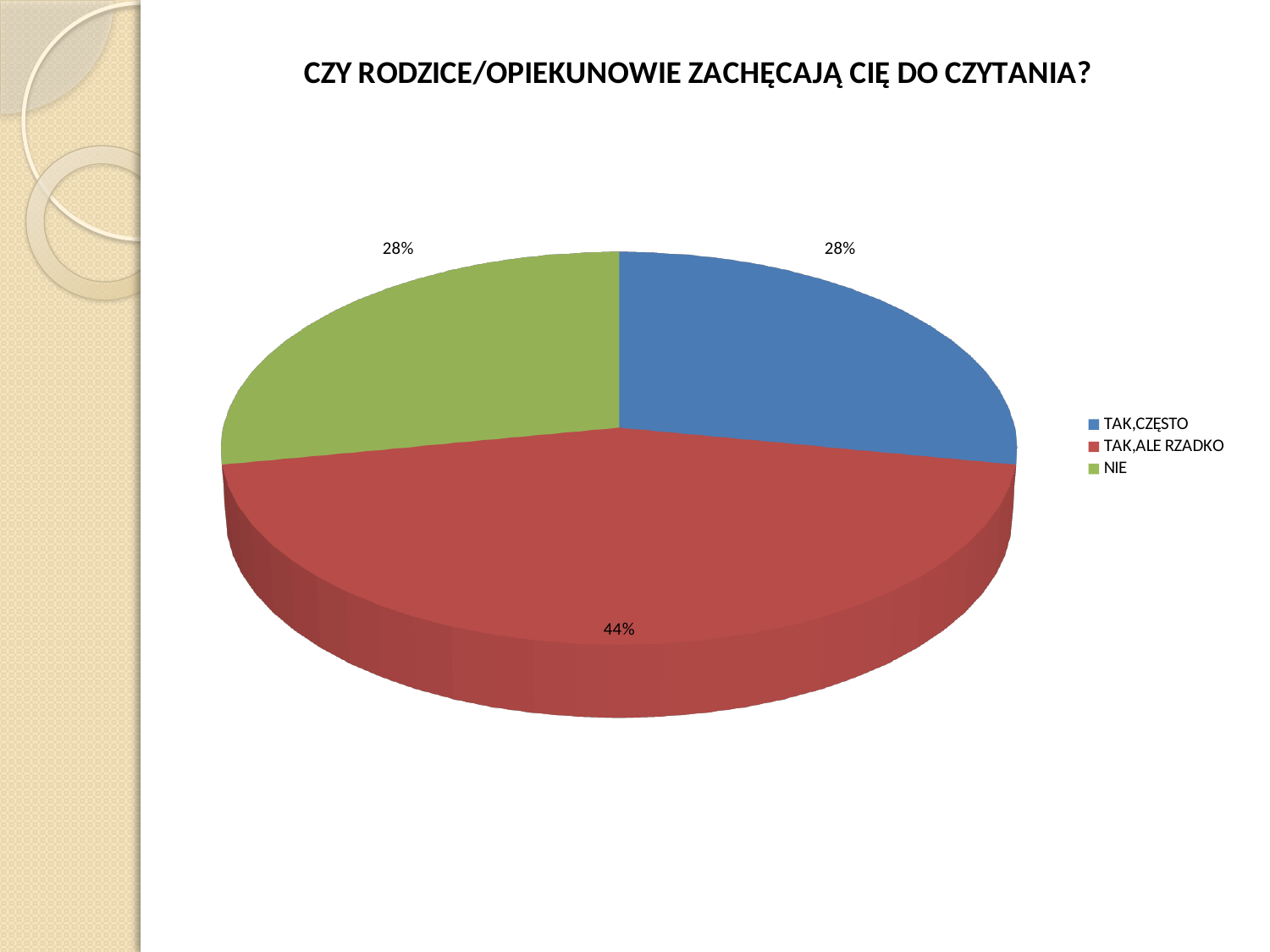
What share of the pie is labelled for TAK,CZĘSTO? 28% What is the combined share of TAK,CZĘSTO and NIE? 56% Which is larger, the slice for TAK,ALE RZADKO or the slice for TAK,CZĘSTO? TAK,ALE RZADKO What is the difference in percentage points between TAK,ALE RZADKO and NIE? 16 What colour is the slice for NIE? green What share of the pie is labelled for TAK,ALE RZADKO? 44% How many entries does the legend list? 3 Which category has the largest slice of the pie? TAK,ALE RZADKO How many slices does the pie chart have? 3 What kind of chart is shown on the slide? pie chart What is the title of the chart? CZY RODZICE/OPIEKUNOWIE ZACHĘCAJĄ CIĘ DO CZYTANIA? What share of the pie is labelled for NIE? 28%